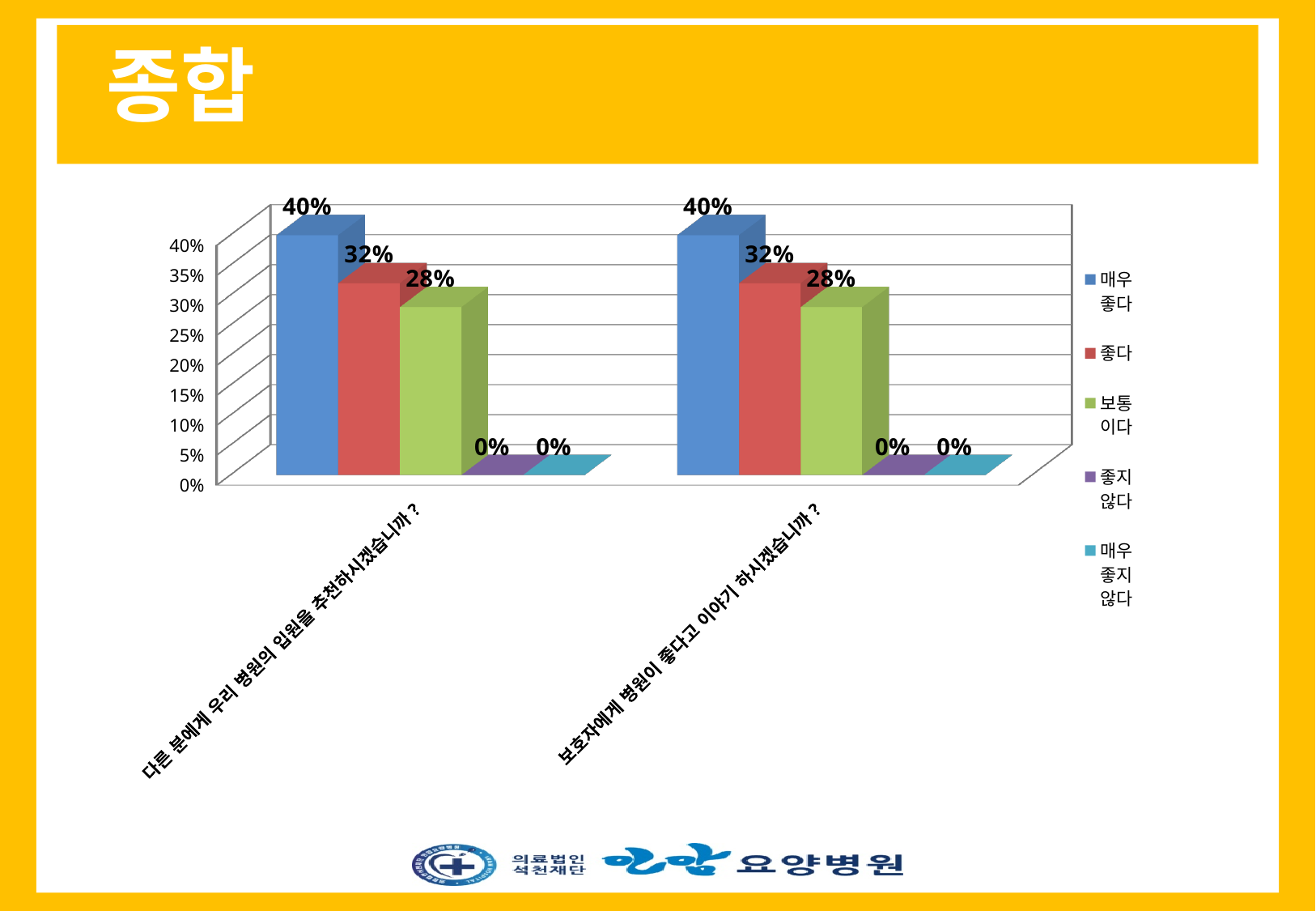
What colour are the bars for the 매우 좋다 series? blue What kind of chart is shown on the slide? bar chart How many series does the legend list? 5 In the category '다른 분에게 우리 병원의 입원을 추천하시겠습니까?', which is larger, 좋다 or 보통이다? 좋다 What is the difference between the 매우 좋다 and 좋다 values in the category '다른 분에게 우리 병원의 입원을 추천하시겠습니까?'? 8% What is the difference between the 좋다 and 보통이다 values in the category '보호자에게 병원이 좋다고 이야기 하시겠습니까?'? 4% What is the value for 매우 좋지 않다 in the category '보호자에게 병원이 좋다고 이야기 하시겠습니까?'? 0% How many categories are shown on the x axis? 2 What is the value for 좋다 in the category '보호자에게 병원이 좋다고 이야기 하시겠습니까?'? 32% Which series has the highest value in the category '보호자에게 병원이 좋다고 이야기 하시겠습니까?'? 매우 좋다 What is the value for 보통이다 in the category '다른 분에게 우리 병원의 입원을 추천하시겠습니까?'? 28% What is the value for 매우 좋다 in the category '다른 분에게 우리 병원의 입원을 추천하시겠습니까?'? 40%